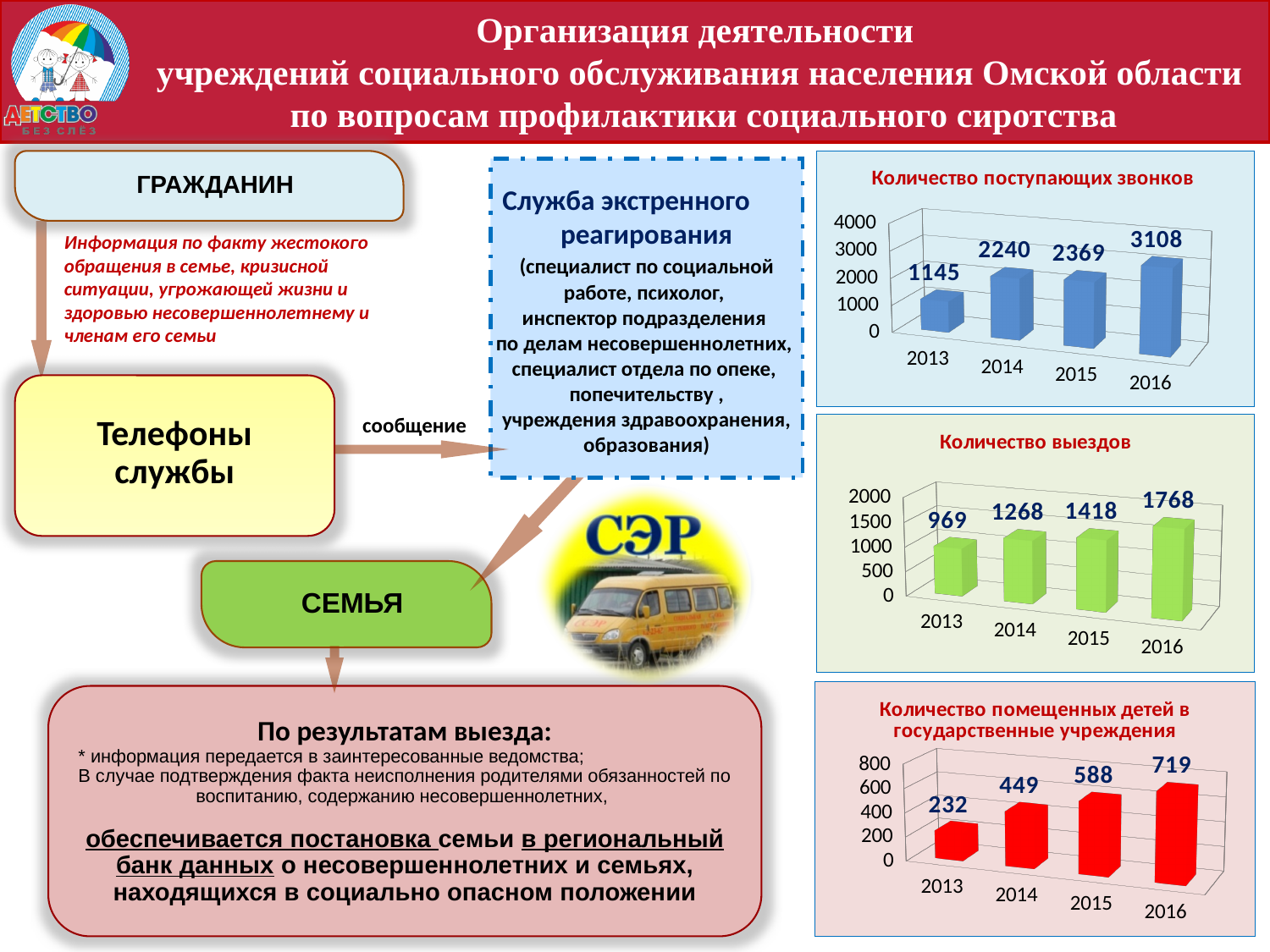
In the chart 'Количество выездов', do the values rise or fall from 2013 to 2016? rise In the chart 'Количество выездов', how many years are shown on the x axis? 4 In the chart 'Количество выездов', which year has the highest value? 2016 In the chart 'Количество поступающих звонков', which year has the lowest value? 2013 In the chart 'Количество поступающих звонков', what is the value for 2016? 3108 In the chart 'Количество помещенных детей в государственные учреждения', which is larger, the value for 2014 or the value for 2013? 2014 In the chart 'Количество поступающих звонков', what is the difference between the values for 2016 and 2013? 1963 In the chart 'Количество выездов', what is the value for 2014? 1268 In the chart 'Количество помещенных детей в государственные учреждения', what is the value for 2015? 588 In the chart 'Количество помещенных детей в государственные учреждения', what is the difference between the values for 2016 and 2015? 131 What type of chart is 'Количество помещенных детей в государственные учреждения'? bar chart What colour are the bars in the chart 'Количество выездов'? green